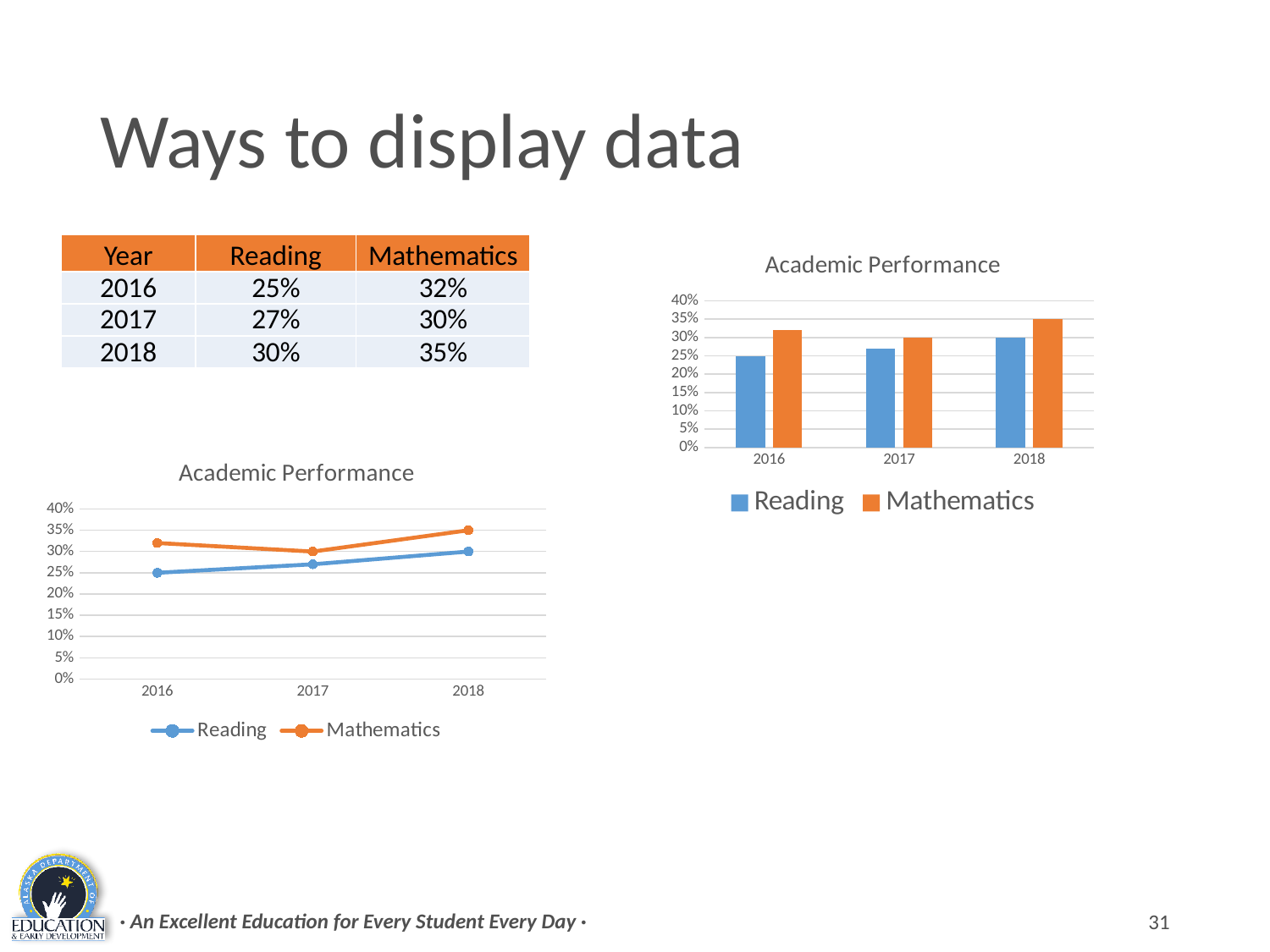
In the top-right bar chart, what is the Mathematics value for 2018? 35% In the bottom-left line chart, does the Reading line rise or fall from 2016 to 2018? rise In the bottom-left line chart, what is the Mathematics value for 2017? 30% What kind of chart is the bottom-left 'Academic Performance' chart? line chart In the top-right bar chart, which is larger in 2016, Reading or Mathematics? Mathematics In the bottom-left line chart, which year has the highest Reading value? 2018 In the top-right bar chart, which year has the lowest Mathematics value? 2017 What kind of chart is the top-right 'Academic Performance' chart? bar chart In the top-right bar chart, what is the Reading value for 2016? 25% In the bottom-left line chart, how many years are shown on the x axis? 3 In the top-right bar chart, how many series does the legend list? 2 In the top-right bar chart, is the Reading value for 2017 greater or less than 30%? less